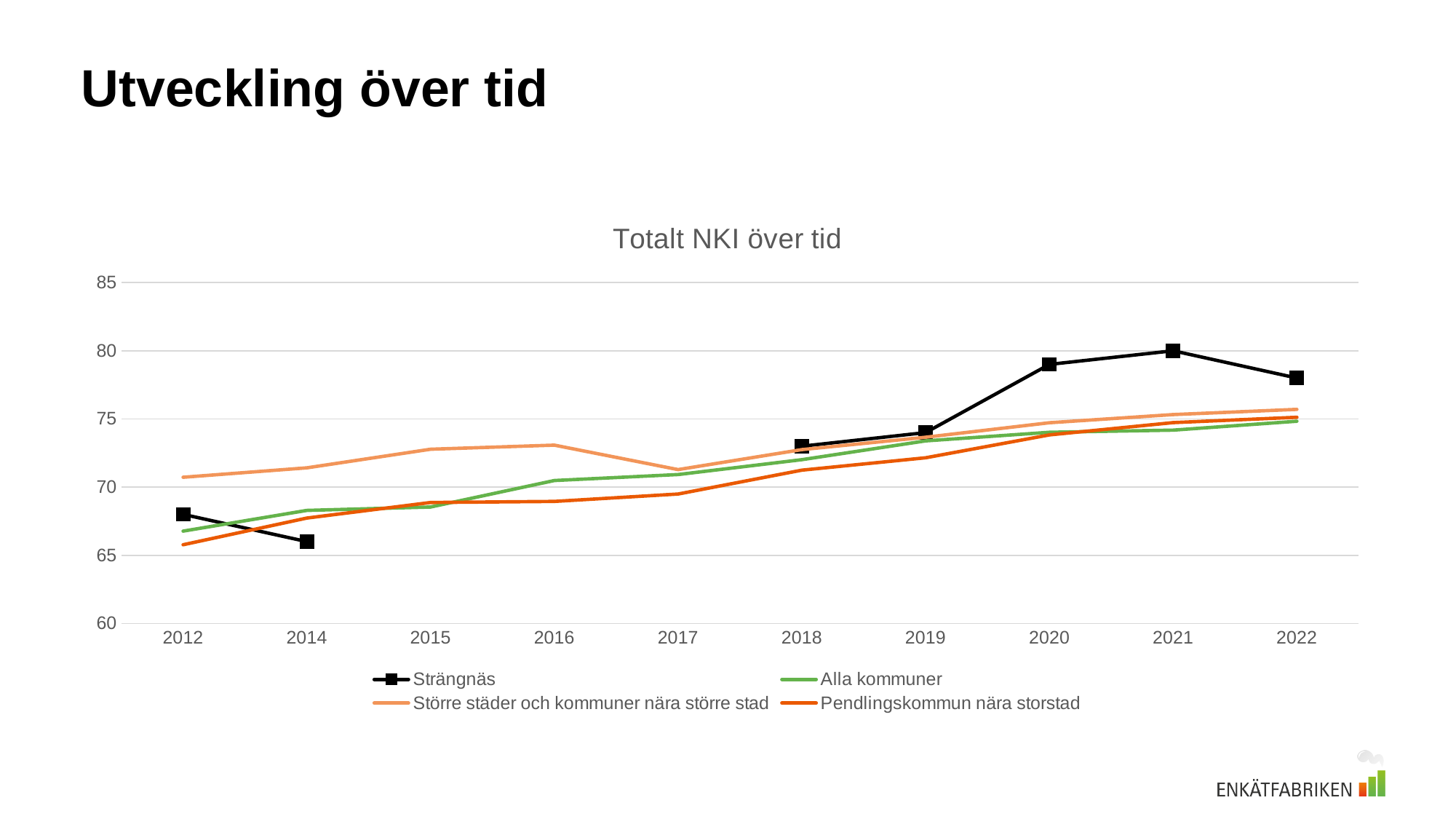
Is the value for Strängnäs in 2020 greater or less than 75? greater In 2020, which is larger: the value for Strängnäs or the value for Alla kommuner? Strängnäs In which year does the Strängnäs series reach its highest value? 2021 What is the value for Strängnäs in 2021? 80 What kind of chart is shown on the slide? line chart Does the Alla kommuner series generally rise or fall from 2012 to 2022? rise Is the value for Större städer och kommuner nära större stad in 2012 greater or less than 70? greater How many series does the legend list? 4 How many years are shown on the x axis? 10 Is the value for Strängnäs in 2014 greater or less than 70? less In which year does the Strängnäs series have its lowest value? 2014 What is the title of the chart? Totalt NKI över tid